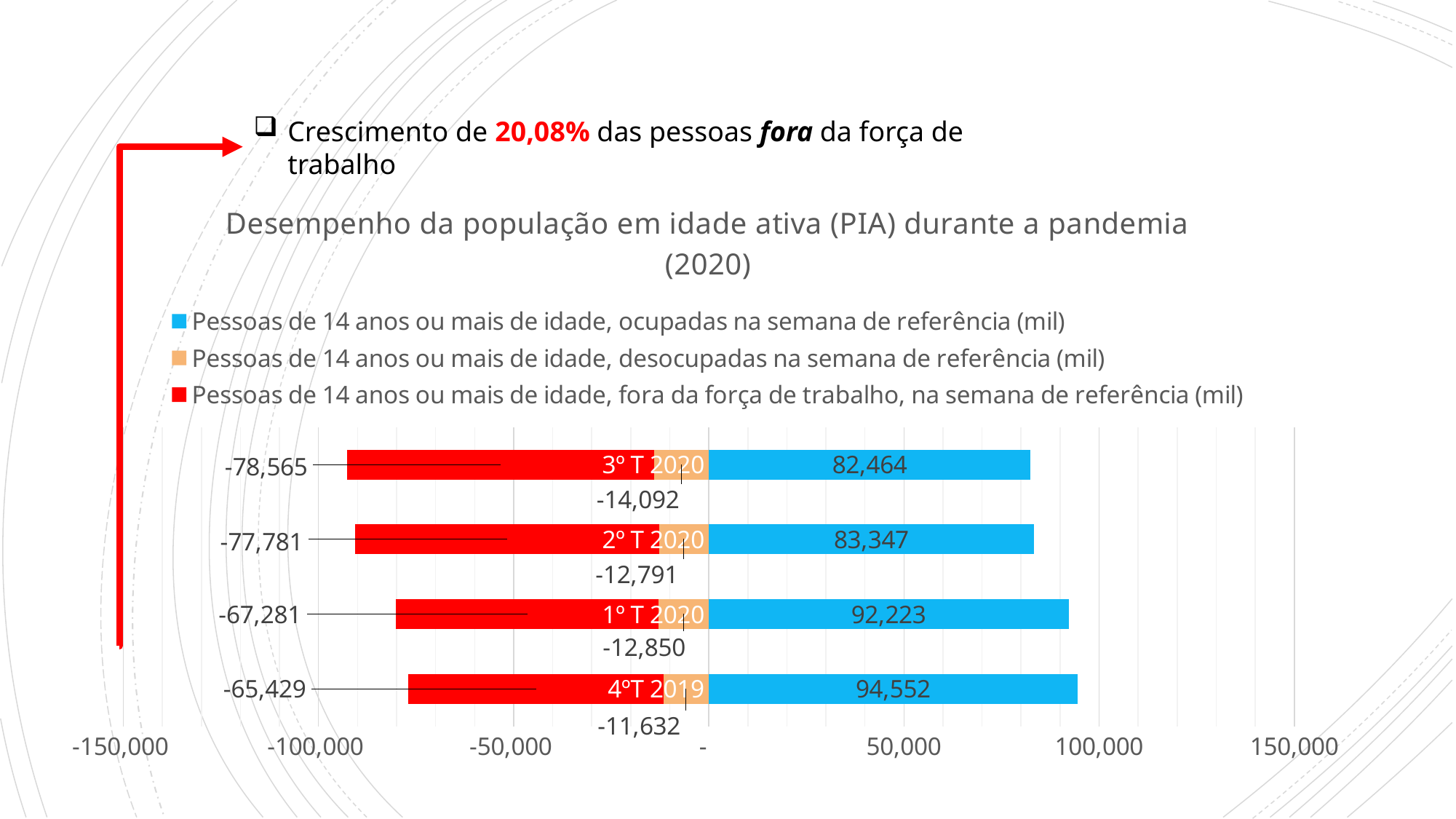
What is the difference between the 'ocupadas' values for 4ºT 2019 and 3º T 2020? 12,088 Which quarter has the lowest value for 'Pessoas de 14 anos ou mais de idade, ocupadas na semana de referência (mil)'? 3º T 2020 Do the 'ocupadas' values rise or fall from 4ºT 2019 to 3º T 2020? fall What is the value for 'Pessoas de 14 anos ou mais de idade, fora da força de trabalho, na semana de referência (mil)' in 4ºT 2019? -65,429 Which is larger in magnitude: the 'desocupadas' value for 3º T 2020 or for 4ºT 2019? 3º T 2020 How many series does the legend list? 3 How many quarters (categories) are plotted in the chart? 4 What type of chart is shown on the slide? bar chart What is the value for 'Pessoas de 14 anos ou mais de idade, ocupadas na semana de referência (mil)' in 3º T 2020? 82,464 What is the title of the chart? Desempenho da população em idade ativa (PIA) durante a pandemia (2020) What is the value for 'Pessoas de 14 anos ou mais de idade, desocupadas na semana de referência (mil)' in 2º T 2020? -12,791 Which quarter has the highest value for 'Pessoas de 14 anos ou mais de idade, ocupadas na semana de referência (mil)'? 4ºT 2019